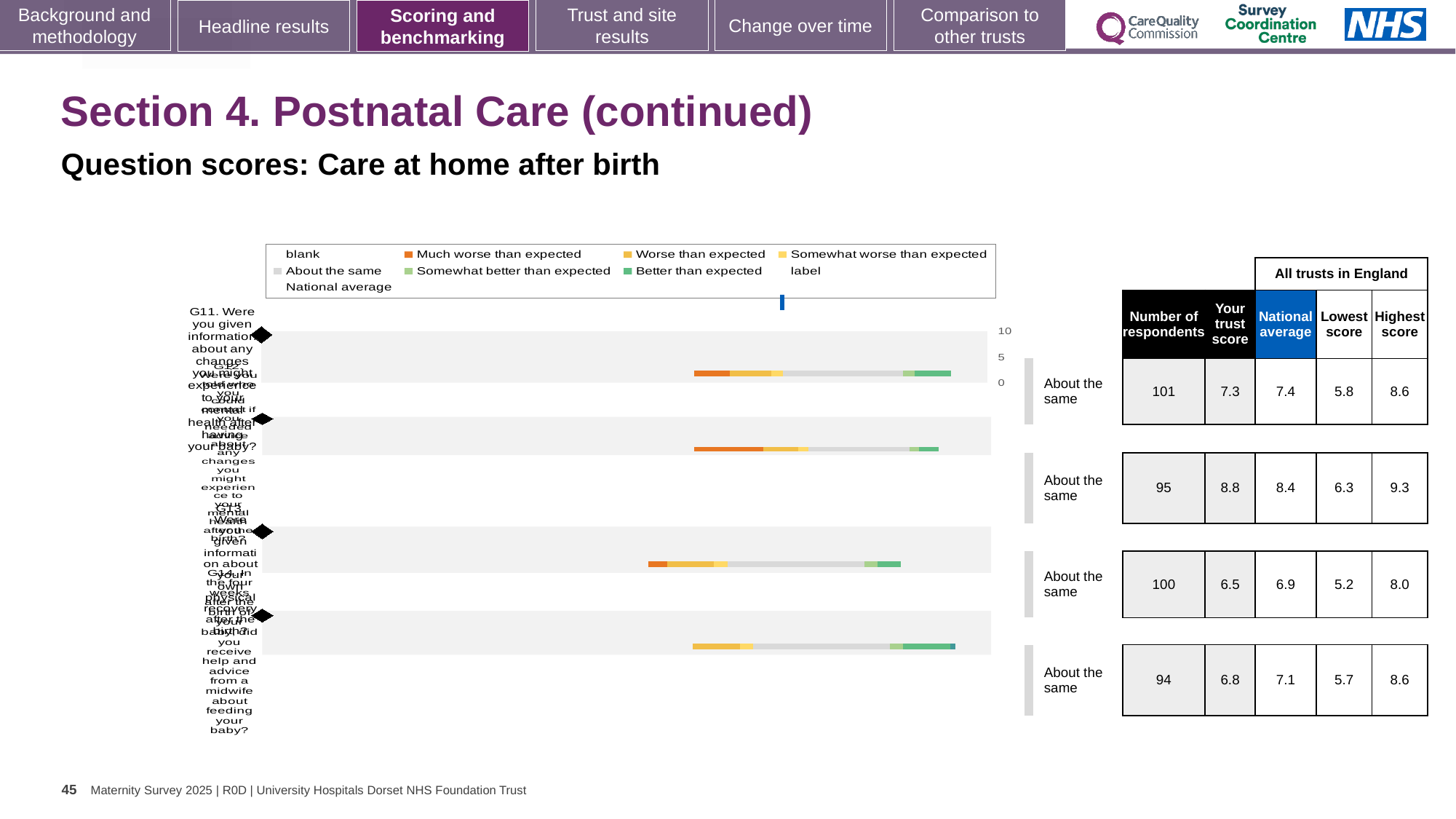
What is the highest tick value shown on the chart's axis? 10 What kind of chart is shown on the slide? bar chart In the table beside the chart, what is the number of respondents in the first row? 101 In the table beside the chart, what is the highest score in the fourth row? 8.6 What colour does the legend use for 'Much worse than expected'? orange In the table beside the chart, what is the 'Your trust score' value in the second row? 8.8 In the table beside the chart, which row has the lowest 'Your trust score'? the third row (6.5) In the table beside the chart, which row has the highest 'Your trust score'? the second row (8.8) How many bars (questions) are plotted in the chart? 4 In the third row of the table, which is larger: the trust score or the national average? the national average (6.9) In the table beside the chart, what is the difference between the national average (7.4) and the trust score (7.3) in the first row? 0.1 How many entries does the chart legend list? 9